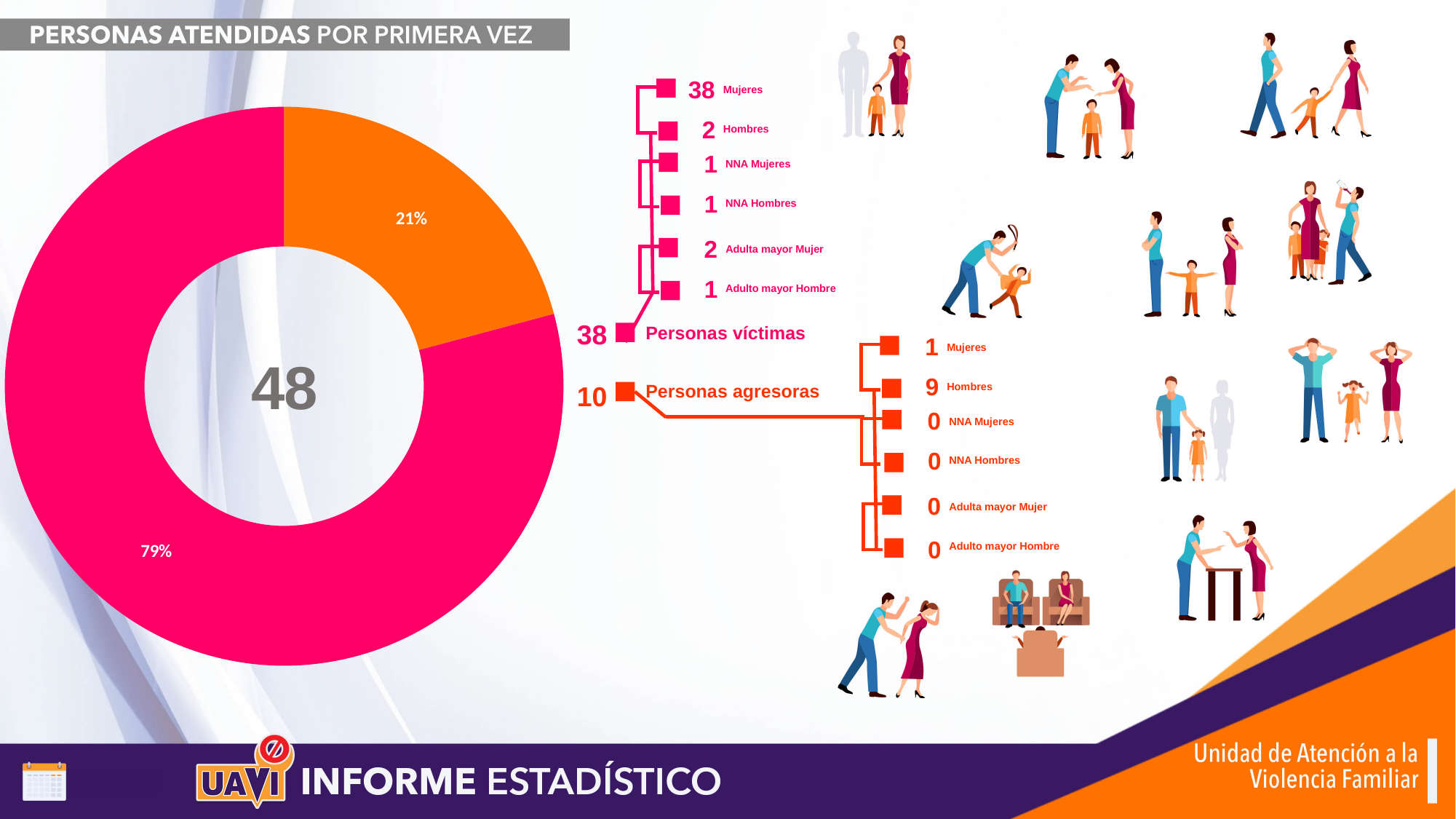
What is the difference between the number of Personas víctimas (38) and Personas agresoras (10)? 28 What percentage is shown on the orange slice of the donut chart? 21% How many slices does the donut chart have? 2 What is the difference in percentage points between the pink slice (79%) and the orange slice (21%)? 58 percentage points What kind of chart is shown on the left of the slide? pie chart (donut) Is the share of the pink slice in the donut chart greater or less than 50%? greater What is the title shown at the top left of the slide? PERSONAS ATENDIDAS POR PRIMERA VEZ What percentage is shown on the pink slice of the donut chart? 79% Which slice of the donut chart is larger, the pink one or the orange one? the pink one (79%) How many 'Personas agresoras' are reported on the slide? 10 What number is printed in the center of the donut chart? 48 How many 'Personas víctimas' are reported on the slide? 38